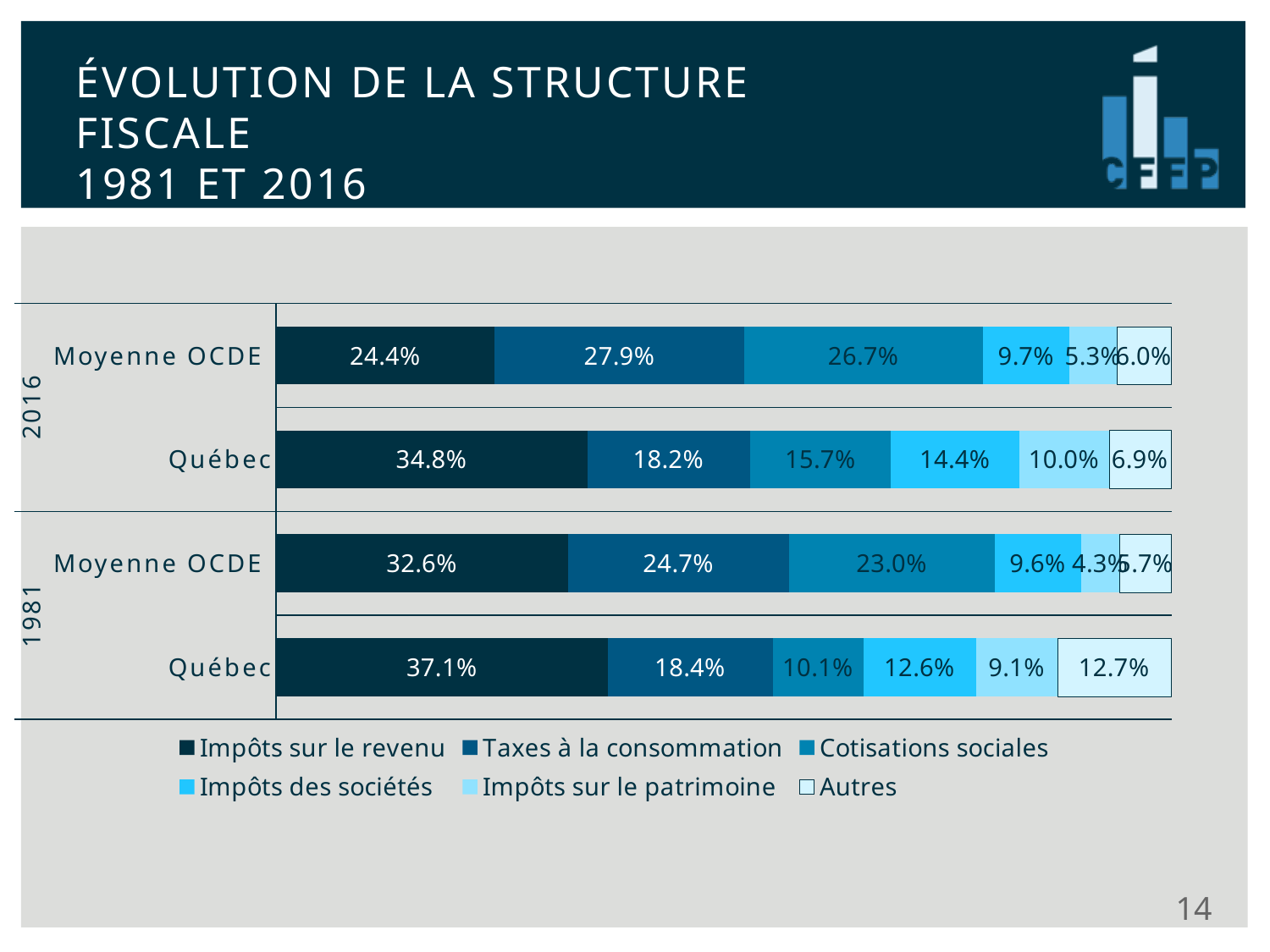
Which is larger: the Cotisations sociales share for Moyenne OCDE in 2016 or for Québec in 2016? Moyenne OCDE 2016 Which of the four bars has the highest share of Impôts sur le revenu? Québec 1981 What is the share of Impôts sur le revenu for Québec in 1981? 37.1% How many bars are plotted in the chart? 4 How many series does the legend list? 6 What is the share of Taxes à la consommation for Moyenne OCDE in 2016? 27.9% What is the share of Impôts sur le revenu for Québec in 2016? 34.8% Which of the four bars has the lowest share of Impôts sur le revenu? Moyenne OCDE 2016 What is the share of Autres for Québec in 1981? 12.7% What is the share of Cotisations sociales for Moyenne OCDE in 1981? 23.0% What is the difference between the Impôts sur le revenu share for Québec in 1981 and in 2016? 2.3 percentage points What kind of chart is shown on the slide? Stacked bar chart